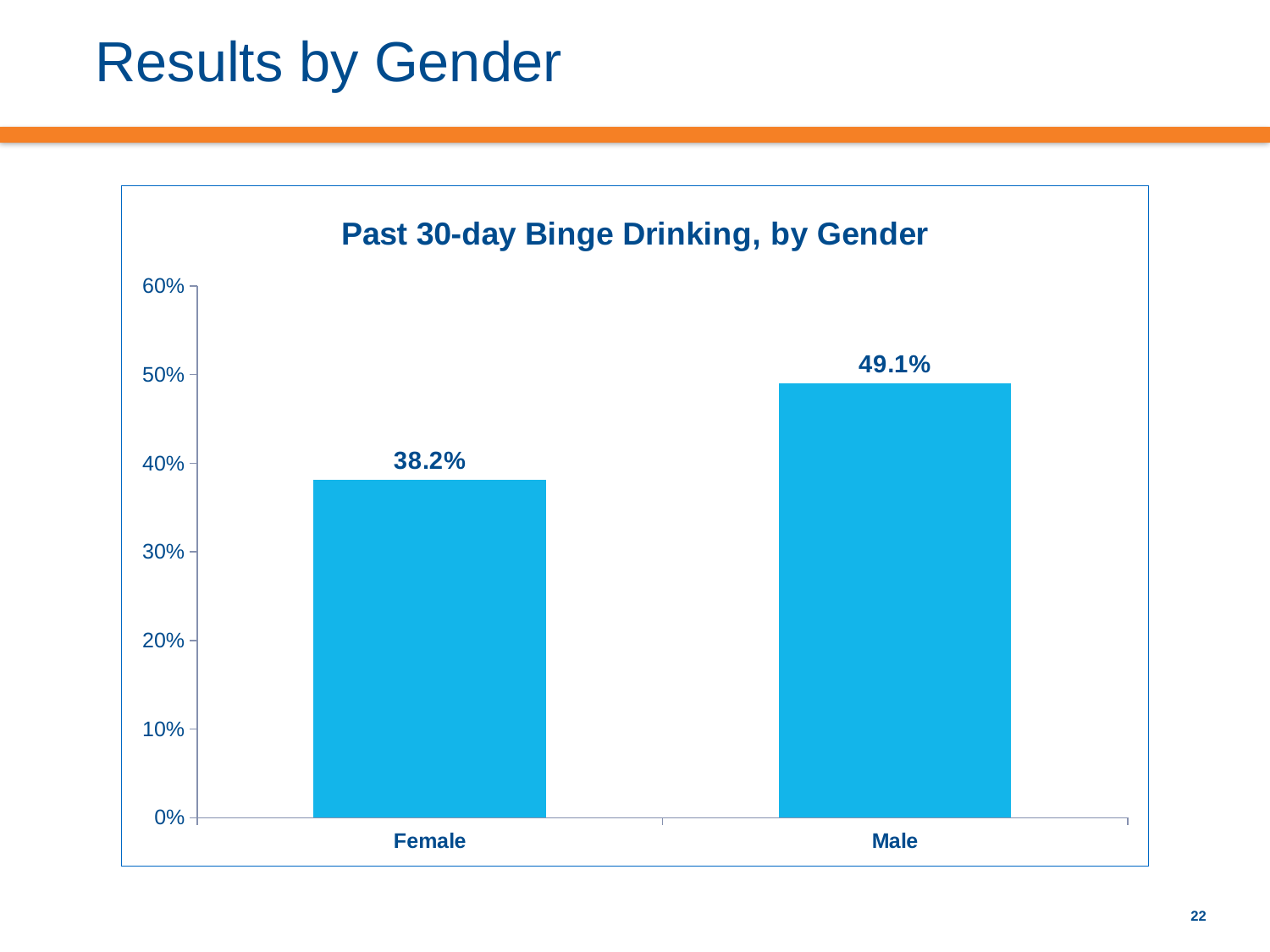
What is the difference between the Male and Female values? 10.9% How many categories are shown on the x axis? 2 What is the value for Male? 49.1% What is the title of the chart? Past 30-day Binge Drinking, by Gender Which gender has the highest past 30-day binge drinking rate? Male Is the value for Female greater or less than 40%? less What is the highest value shown on the y axis? 60% Which is larger, the value for Female or the value for Male? Male Which gender has the lowest past 30-day binge drinking rate? Female What is the value for Female? 38.2% Is the value for Male greater or less than 40%? greater What kind of chart is shown on the slide? bar chart